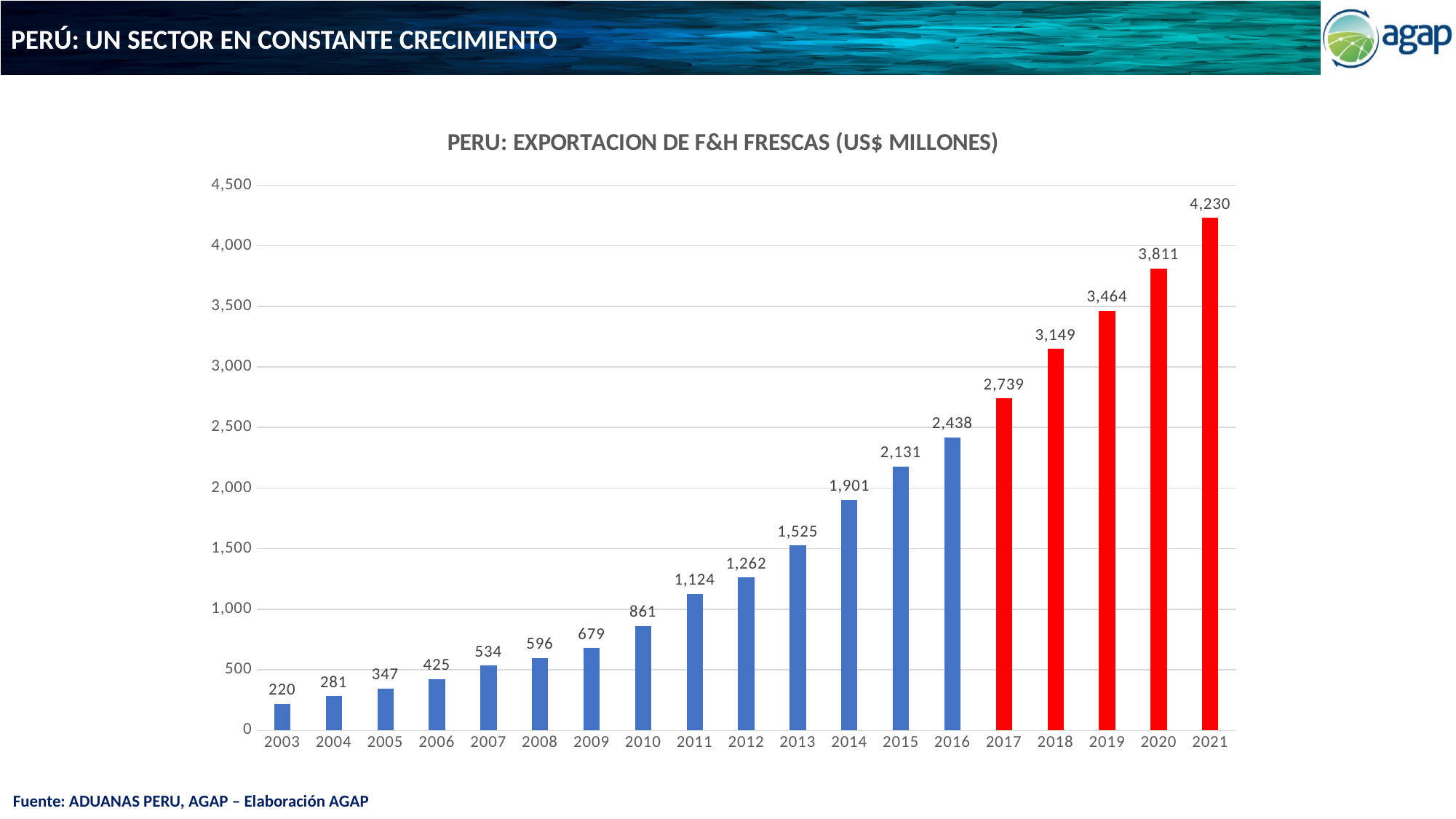
What kind of chart is shown on the slide? Bar chart Is the value for 2018 greater or less than 3,000? greater What is the export value shown for 2010? 861 How many years are shown on the x axis? 19 Which year has the lowest export value? 2003 What is the difference between the export values for 2016 and 2015? 307 Which year has a larger export value, 2013 or 2014? 2014 What is the export value shown for 2021? 4,230 What is the export value shown for 2017? 2,739 Which year has the highest export value? 2021 Do the export values rise or fall from 2003 to 2021? Rise What is the difference between the export values for 2021 and 2020? 419